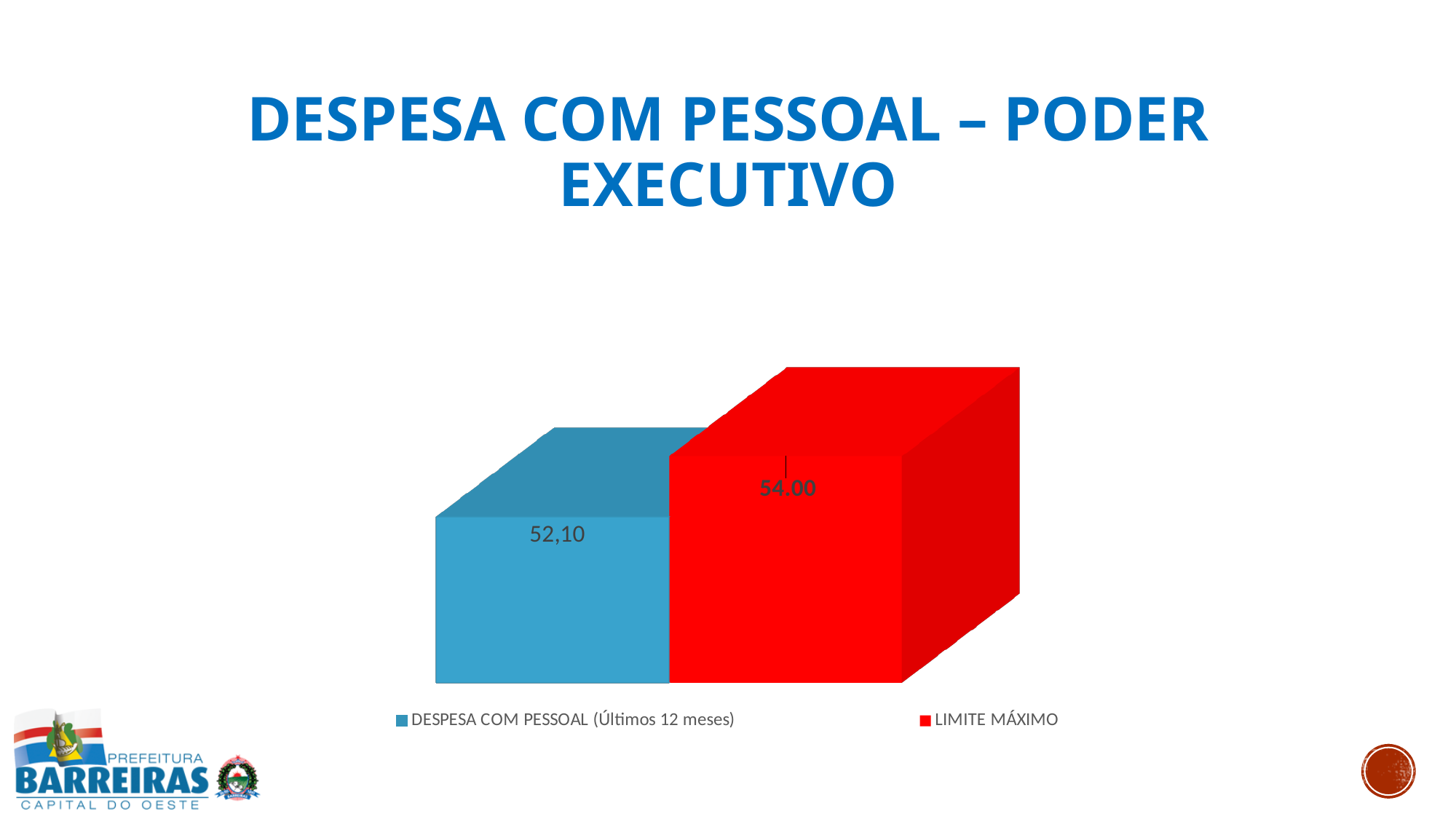
What is the value for LIMITE MÁXIMO? 54.00 What kind of chart is shown on the slide? Bar chart How many series does the legend list? 2 Which series has the higher value, DESPESA COM PESSOAL (Últimos 12 meses) or LIMITE MÁXIMO? LIMITE MÁXIMO How many bars are plotted in the chart? 2 What is the title of the slide? DESPESA COM PESSOAL – PODER EXECUTIVO Which series has the lowest value? DESPESA COM PESSOAL (Últimos 12 meses) What is the value for DESPESA COM PESSOAL (Últimos 12 meses)? 52,10 What is the difference between LIMITE MÁXIMO and DESPESA COM PESSOAL (Últimos 12 meses)? 1,90 Which series has the highest value? LIMITE MÁXIMO What colour is the bar for LIMITE MÁXIMO? Red